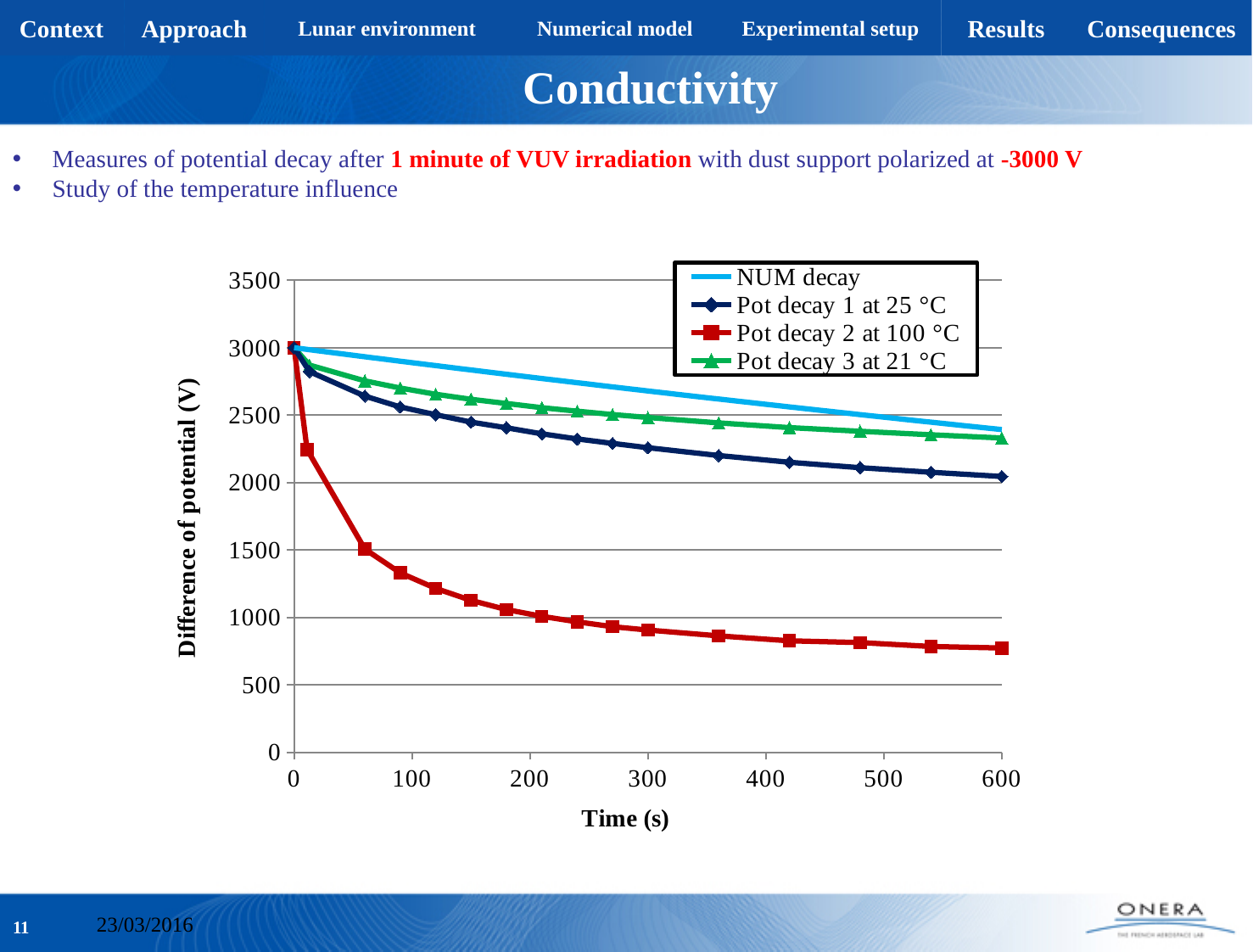
What is the title of the vertical axis? Difference of potential (V) What is the value of Pot decay 2 at 100 °C at time 0 s? 3000 Is the value for Pot decay 2 at 100 °C at 90 s greater or less than 1000? greater How many series does the chart legend list? 4 Is the value for Pot decay 2 at 100 °C at 600 s greater or less than 1000? less Is the value for NUM decay at 600 s greater or less than 2500? less Which series has the highest difference of potential at 600 s? NUM decay What kind of chart is shown on the slide? line chart Which series has the lowest difference of potential at 600 s? Pot decay 2 at 100 °C At 300 s, which is larger: Pot decay 1 at 25 °C or Pot decay 3 at 21 °C? Pot decay 3 at 21 °C What colour is the Pot decay 2 at 100 °C series? red Do the values of Pot decay 1 at 25 °C rise or fall as time increases? fall